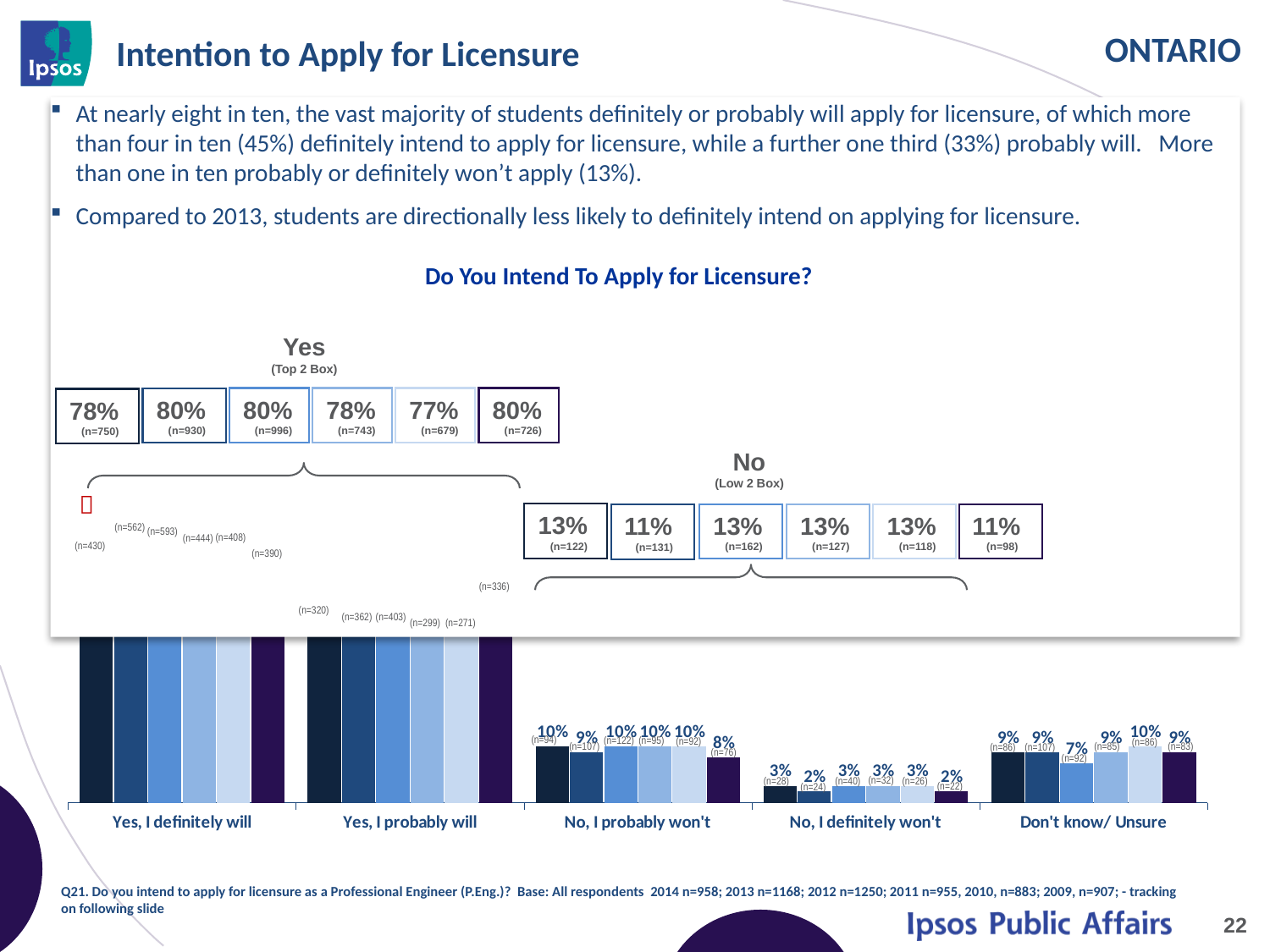
Which response category has the shortest bars in the chart? No, I definitely won't How many bars are plotted for each response category in the chart? 6 What is the value of the last (dark purple) bar in the 'No, I probably won't' category? 8% What is the value of the third bar in the 'Don't know/ Unsure' category? 7% How many response categories are shown along the x axis of the chart? 5 What is the title of the chart on the slide? Do You Intend To Apply for Licensure? Which is larger: the first bar for 'No, I probably won't' or the first bar for 'No, I definitely won't'? No, I probably won't Which response category has the tallest bars in the chart? Yes, I definitely will What kind of chart is shown under the title 'Do You Intend To Apply for Licensure?'? bar chart What is the difference between the first bar for 'No, I probably won't' (10%) and the first bar for 'No, I definitely won't' (3%)? 7 percentage points What is the value of the fifth bar in the 'Don't know/ Unsure' category? 10% What is the first 'Yes (Top 2 Box)' value shown above the chart? 78%